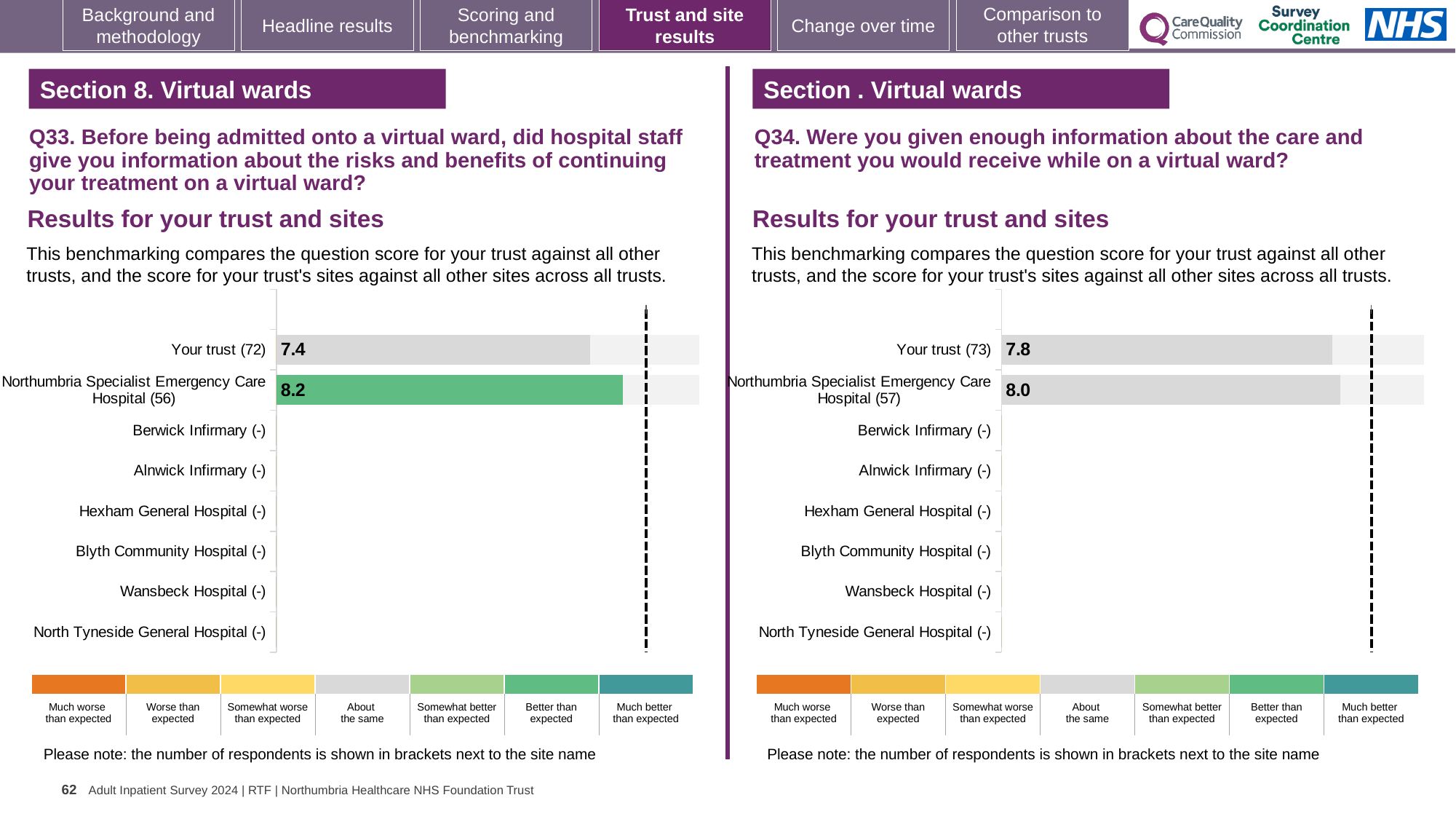
On the Q34 chart (right), which has the higher score: Your trust or Northumbria Specialist Emergency Care Hospital? Northumbria Specialist Emergency Care Hospital On the Q34 chart (right), what is the difference between the Northumbria Specialist Emergency Care Hospital score and the Your trust score? 0.2 On the Q34 chart (right), what is the score for Your trust (73)? 7.8 On the Q33 chart (left), what is the score for Your trust (72)? 7.4 What type of chart is used on the Q33 chart (left)? Bar chart On the Q33 chart (left), what is the difference between the Northumbria Specialist Emergency Care Hospital score and the Your trust score? 0.8 How many benchmark categories are shown in the colour key below the Q34 chart (right)? 7 On the Q34 chart (right), what is the score for Northumbria Specialist Emergency Care Hospital (57)? 8.0 On the Q33 chart (left), what is the score for Northumbria Specialist Emergency Care Hospital (56)? 8.2 On the Q33 chart (left), which has the higher score: Your trust or Northumbria Specialist Emergency Care Hospital? Northumbria Specialist Emergency Care Hospital How many site/trust categories are listed on the Q34 chart (right)? 8 On the Q33 chart (left), which benchmark category does the colour of the Northumbria Specialist Emergency Care Hospital bar correspond to? Better than expected